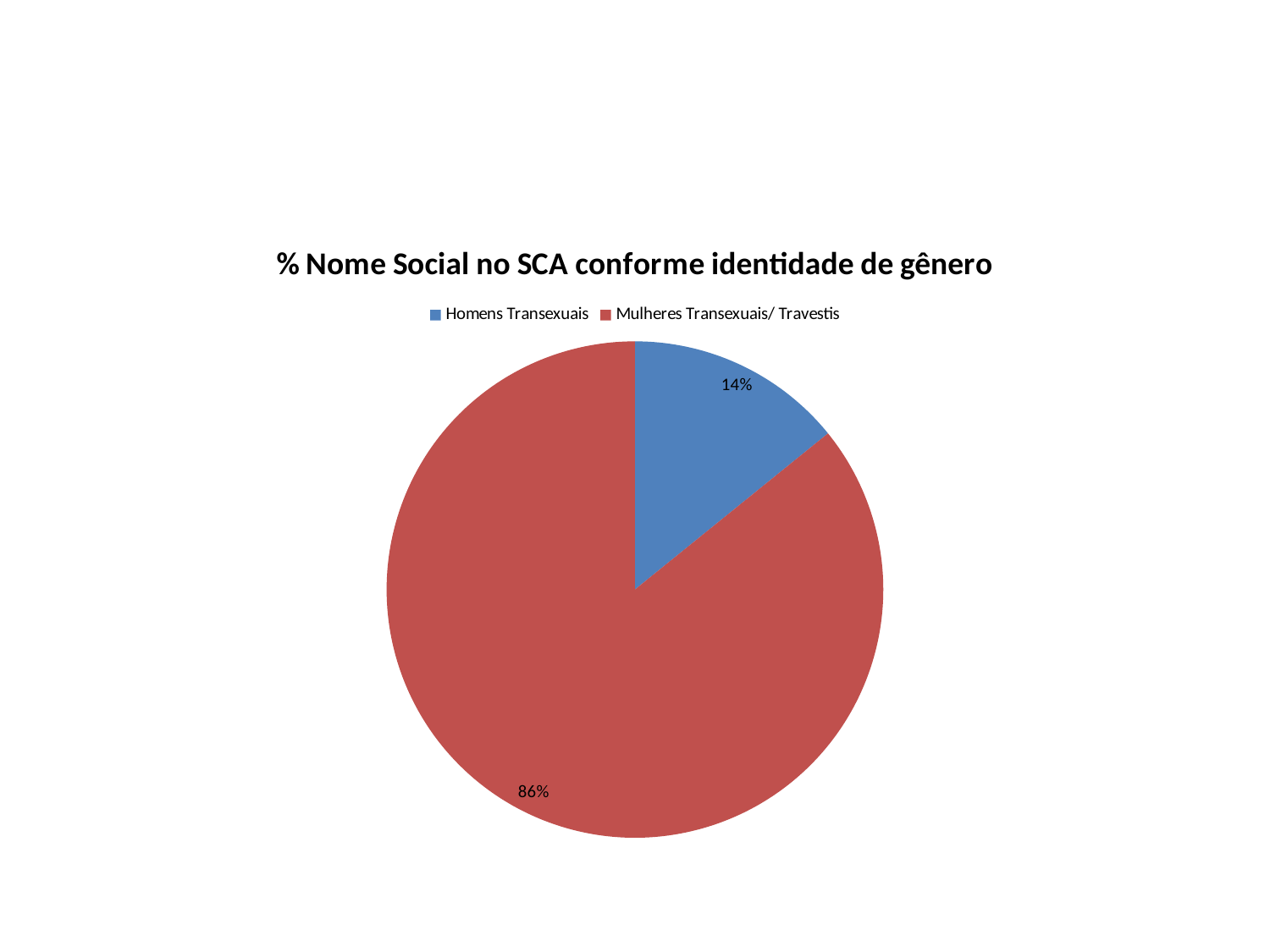
What colour is the Mulheres Transexuais/ Travestis slice? Red Which category has the smallest share of the pie? Homens Transexuais What kind of chart is shown on the slide? Pie chart What is the difference in percentage points between the Mulheres Transexuais/ Travestis slice and the Homens Transexuais slice? 72 Which slice is larger, Homens Transexuais or Mulheres Transexuais/ Travestis? Mulheres Transexuais/ Travestis What percentage of the pie is labelled for Homens Transexuais? 14% What is the title of the chart? % Nome Social no SCA conforme identidade de gênero Which category has the largest share of the pie? Mulheres Transexuais/ Travestis How many slices does the pie chart have? 2 What percentage of the pie is labelled for Mulheres Transexuais/ Travestis? 86% What share of the pie does the Homens Transexuais slice represent? 14% How many entries does the legend list? 2